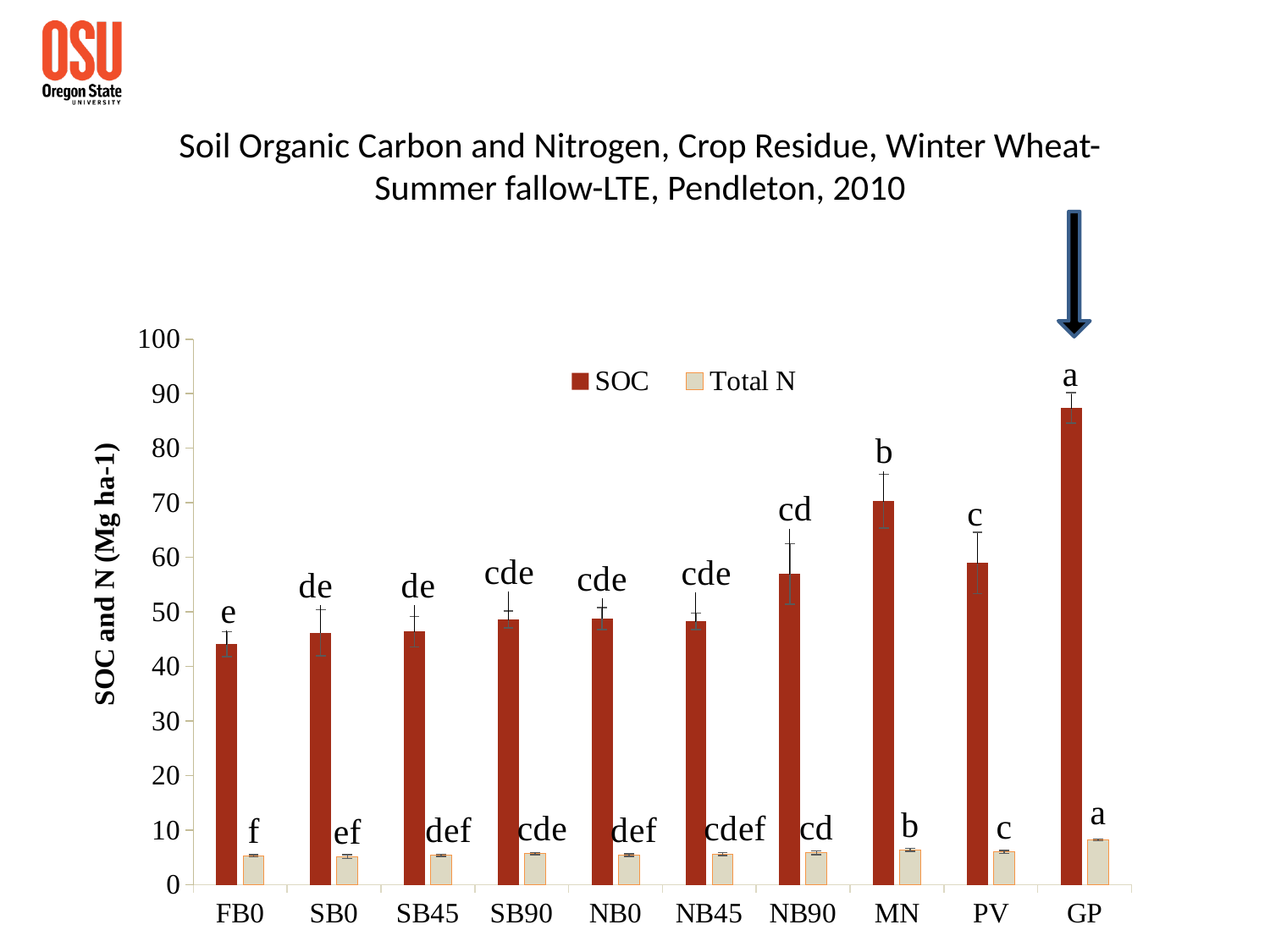
Which category has the highest Total N value? GP Is the SOC value for MN greater or less than 60? greater Which has the larger SOC value, MN or PV? MN What kind of chart is shown on the slide? bar chart How many categories are shown along the x axis? 10 Is the SOC value for FB0 greater or less than 50? less How many series does the legend list? 2 What is the y-axis title of the chart? SOC and N (Mg ha-1) Is the Total N value for FB0 greater or less than 10? less Which category has the highest SOC value? GP Which has the larger SOC value, NB90 or SB0? NB90